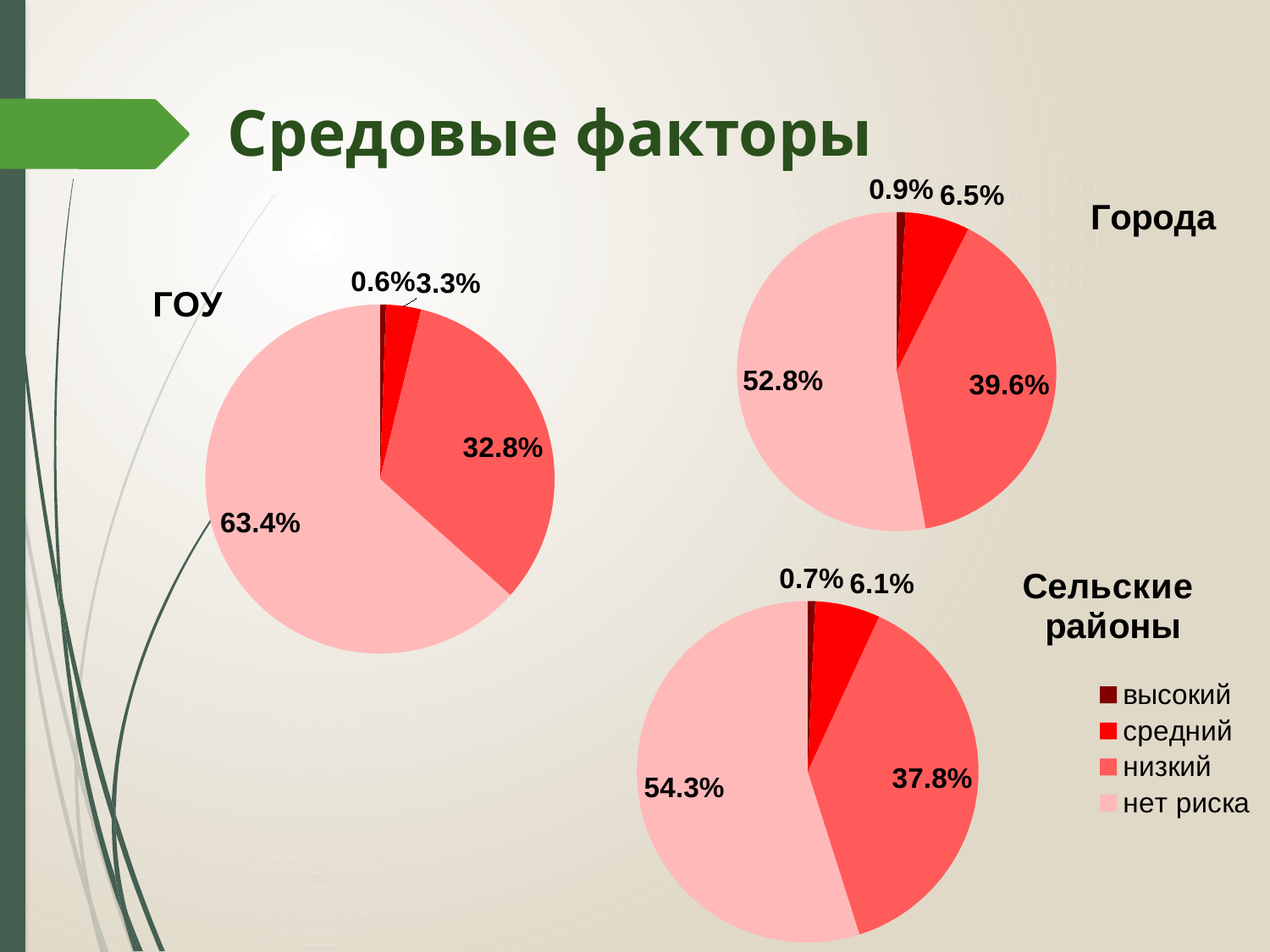
How many slices does the ГОУ pie chart have? 4 What is the title of the slide containing the three pie charts? Средовые факторы In the Города pie chart, what share is labelled for the 'средний' slice? 6.5% In the Сельские районы pie chart, which category has the smallest slice? высокий How many entries does the legend list? 4 In the Города pie chart, which category has the largest slice? нет риска In the Сельские районы pie chart, what share is labelled for the 'высокий' slice? 0.7% In the ГОУ pie chart, what share is labelled for the 'низкий' slice? 32.8% In the Города pie chart, what is the difference between the 'нет риска' and 'низкий' shares? 13.2% What type of chart is used for the Сельские районы data? Pie chart Which is larger: the 'низкий' share in the Города chart or the 'низкий' share in the Сельские районы chart? Города In the ГОУ pie chart, what share is labelled for the 'нет риска' slice? 63.4%